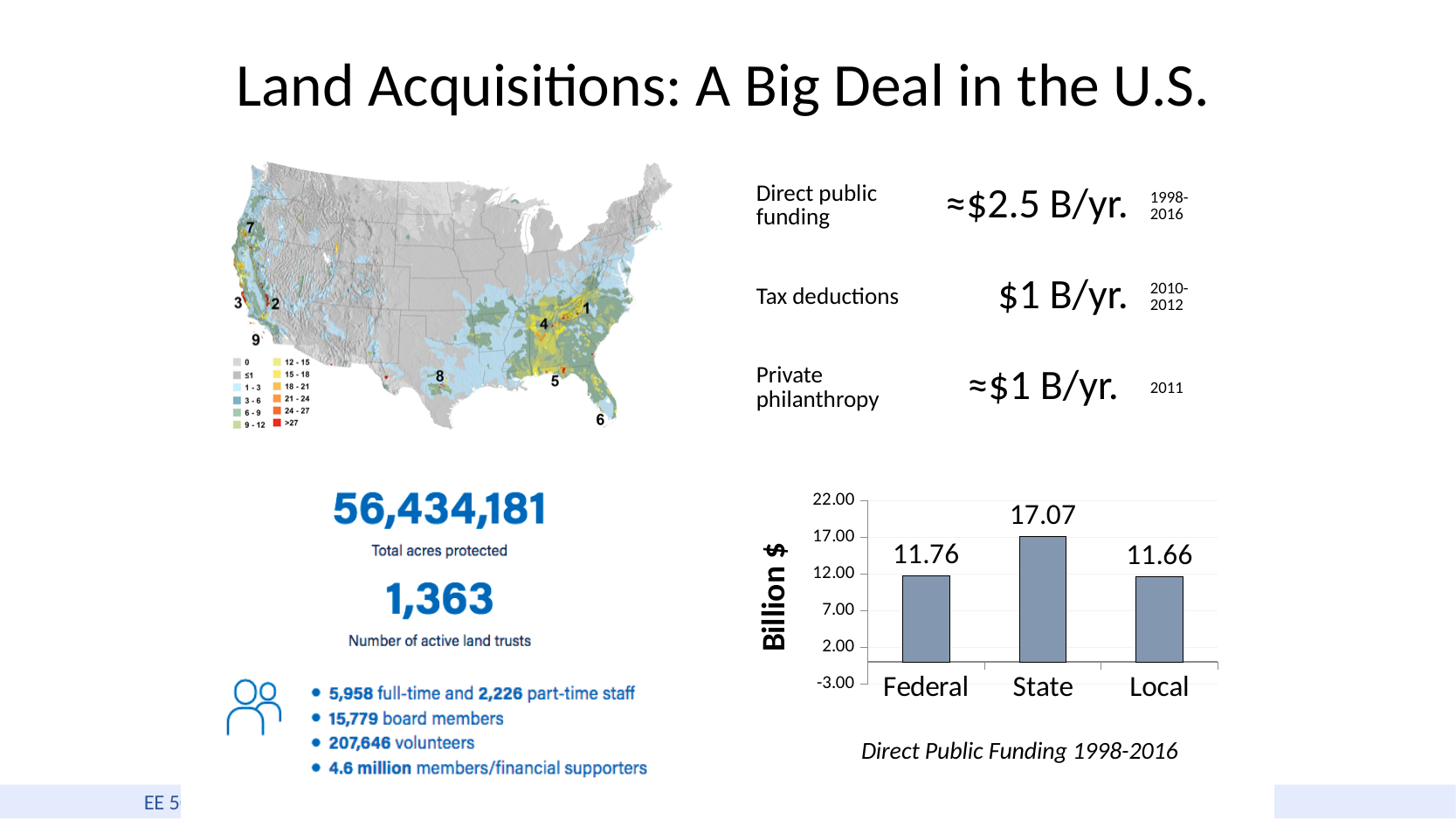
In the Direct Public Funding 1998-2016 chart, which is larger, the value for Federal or the value for Local? Federal In the Direct Public Funding 1998-2016 chart, is the value for State greater or less than 12.00? greater In the Direct Public Funding 1998-2016 chart, what is the value for State? 17.07 In the Direct Public Funding 1998-2016 chart, what is the value for Federal? 11.76 How many categories are shown in the Direct Public Funding 1998-2016 chart? 3 What kind of chart is the Direct Public Funding 1998-2016 chart? bar chart In the Direct Public Funding 1998-2016 chart, which category has the highest value? State In the Direct Public Funding 1998-2016 chart, which category has the lowest value? Local In the Direct Public Funding 1998-2016 chart, what is the value for Local? 11.66 What is the label on the vertical axis of the Direct Public Funding 1998-2016 chart? Billion $ In the Direct Public Funding 1998-2016 chart, what is the difference between the State and Federal values? 5.31 In the Direct Public Funding 1998-2016 chart, what is the difference between the Federal and Local values? 0.10